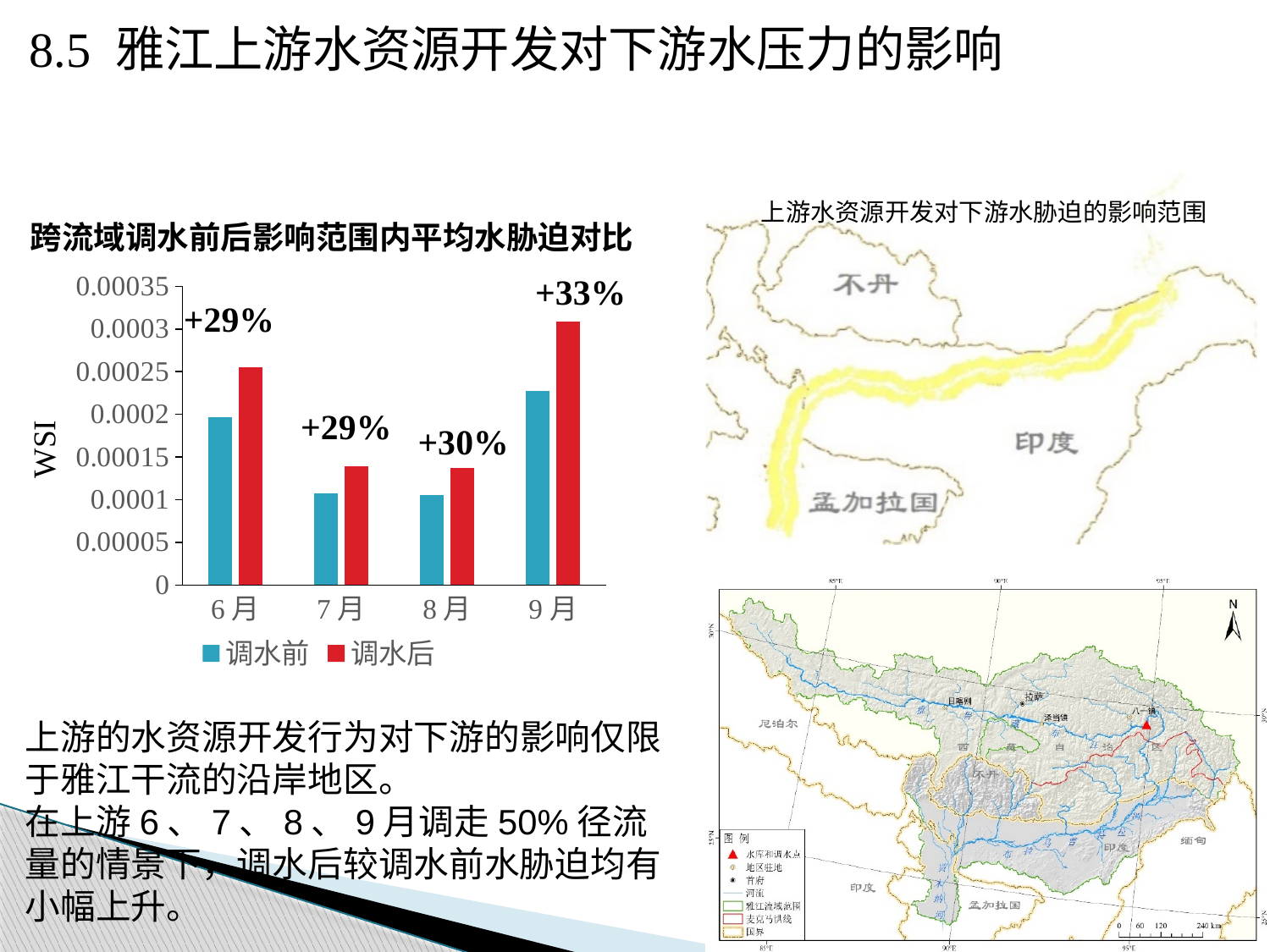
What is the title of the chart? 跨流域调水前后影响范围内平均水胁迫对比 How many series does the chart legend list? 2 What is the y-axis label of the chart? WSI Is the 调水后 value for 8月 greater or less than 0.00015? less What percentage increase is labelled above the bars for 8月? +30% Is the 调水前 value for 9月 greater or less than 0.0002? greater Which month has the highest labelled percentage increase? 9月 How many month categories are shown on the x axis of the chart? 4 What percentage increase is labelled above the bars for 9月? +33% What percentage increase is labelled above the bars for 6月? +29% What kind of chart is shown on the slide? bar chart Which month has the highest 调水后 bar? 9月